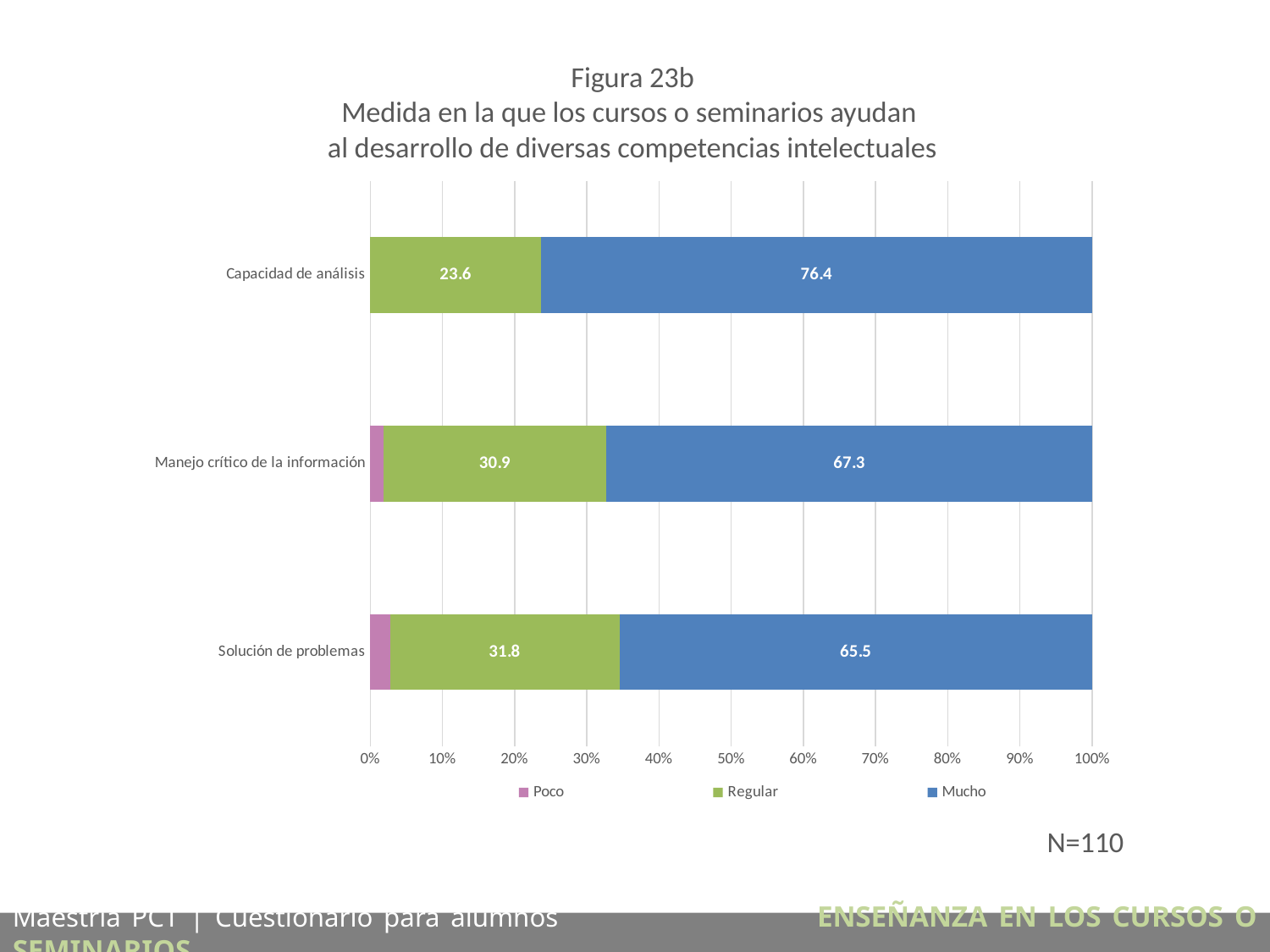
What kind of chart is shown on the slide? Stacked bar chart What is the difference between the Mucho values for Capacidad de análisis and Solución de problemas? 10.9 What is the value of the Regular series for Capacidad de análisis? 23.6 How many categories are shown on the chart? 3 Which is larger: the Regular value for Manejo crítico de la información or the Regular value for Solución de problemas? Solución de problemas Which category has the highest value for the Mucho series? Capacidad de análisis Is the Poco value for Solución de problemas greater or less than 10%? less What is the value of the Mucho series for Capacidad de análisis? 76.4 What is the value of the Regular series for Solución de problemas? 31.8 What is the value of the Mucho series for Manejo crítico de la información? 67.3 How many series does the legend list? 3 Which category has the lowest value for the Regular series? Capacidad de análisis